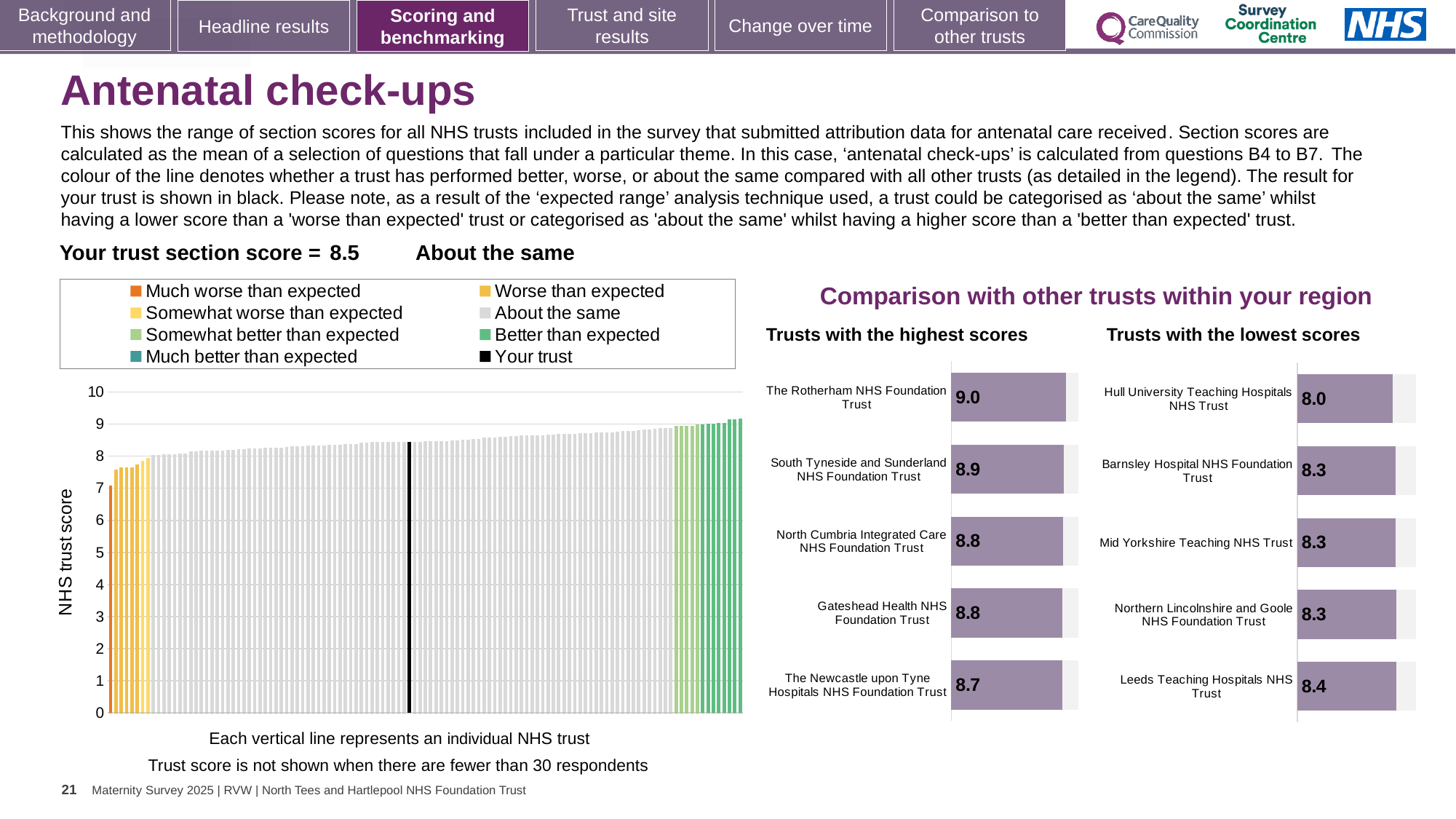
In the 'Trusts with the highest scores' chart, which trust has the highest score? The Rotherham NHS Foundation Trust In the 'Trusts with the lowest scores' chart, what is the score for Hull University Teaching Hospitals NHS Trust? 8.0 In the 'Trusts with the highest scores' chart, what is the difference between the scores of The Rotherham NHS Foundation Trust and The Newcastle upon Tyne Hospitals NHS Foundation Trust? 0.3 In the 'Trusts with the lowest scores' chart, which trust has the lowest score? Hull University Teaching Hospitals NHS Trust In the large chart on the left, how many entries does the legend list? 8 In the 'Trusts with the highest scores' chart, how many trusts are shown? 5 In the large chart on the left, what is the label on the vertical axis? NHS trust score In the large chart on the left, do the bars rise or fall from left to right? Rise What kind of chart is the large chart on the left showing NHS trust scores? Bar chart In the large chart on the left, is the value for the black 'Your trust' bar greater or less than 8? greater In the 'Trusts with the lowest scores' chart, which has the larger score: Leeds Teaching Hospitals NHS Trust or Hull University Teaching Hospitals NHS Trust? Leeds Teaching Hospitals NHS Trust In the 'Trusts with the highest scores' chart, what is the score for The Rotherham NHS Foundation Trust? 9.0